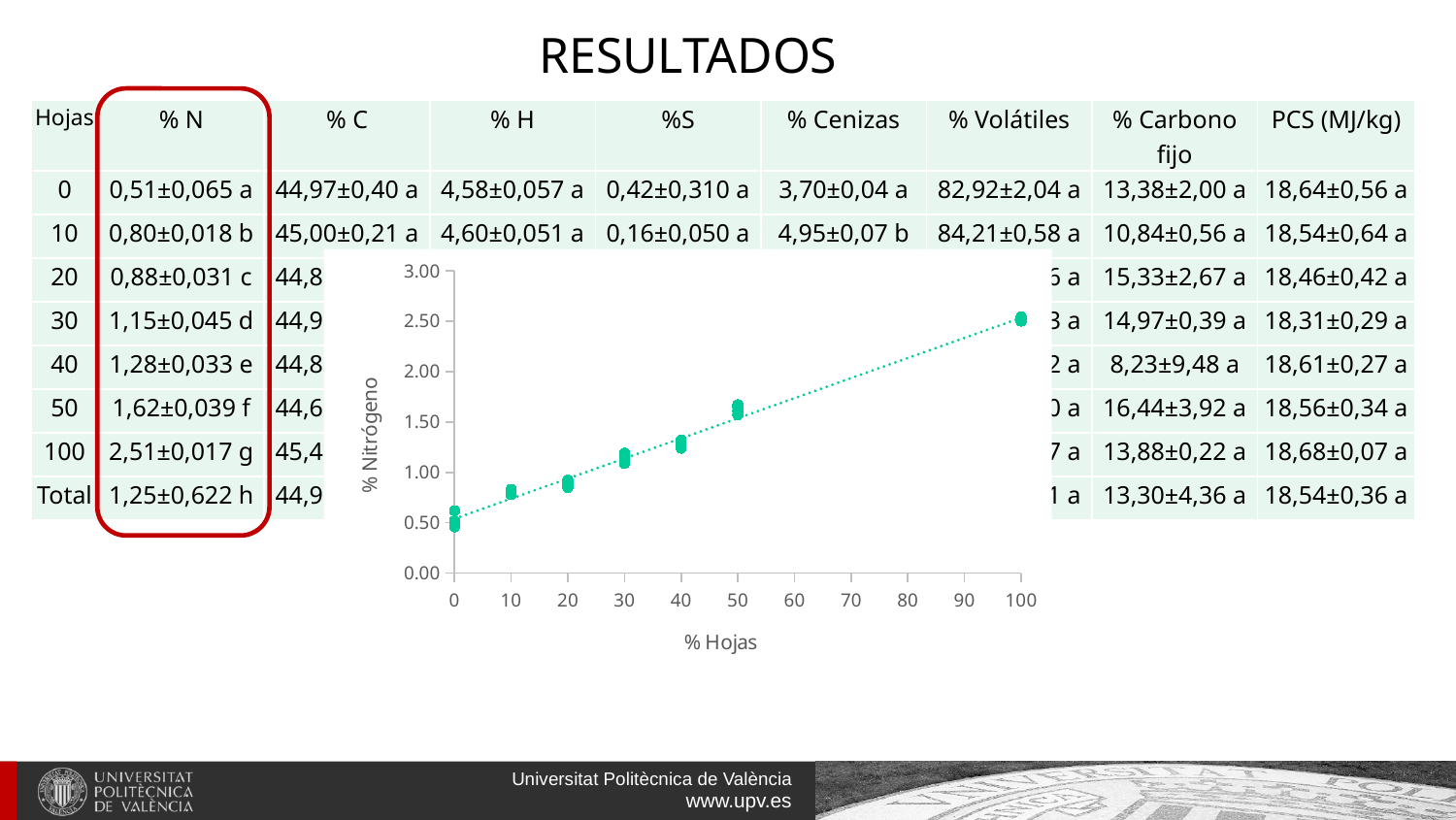
Is the % Nitrógeno value at 0 % Hojas greater or less than 1.00? less Which has a larger % Nitrógeno value, 50 % Hojas or 10 % Hojas? 50 % Hojas What kind of chart is shown on the slide? Scatter chart How many distinct % Hojas levels have points plotted on the chart? 7 Do the % Nitrógeno values rise or fall as % Hojas increases along the x axis? Rise Is the % Nitrógeno value at 100 % Hojas greater or less than 2.00? greater What is the title of the x axis of the chart? % Hojas At which % Hojas level is the plotted % Nitrógeno lowest? 0 At which % Hojas level is the plotted % Nitrógeno highest? 100 Is the % Nitrógeno value at 40 % Hojas greater or less than 1.00? greater What is the title of the y axis of the chart? % Nitrógeno